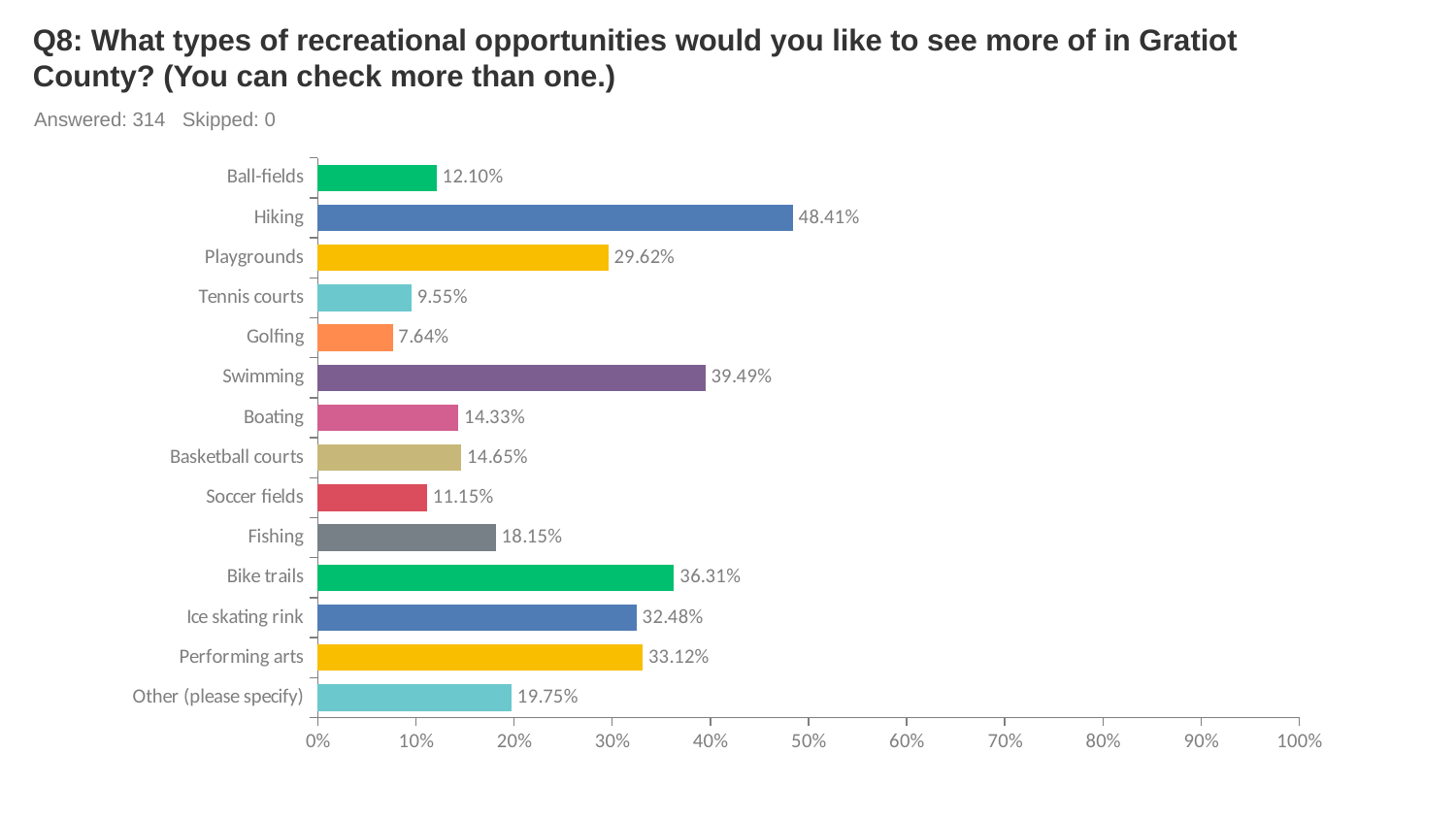
How many categories are shown in the chart? 14 How many respondents answered the question according to the slide? 314 Which category has the lowest percentage? Golfing What percentage is shown for Other (please specify)? 19.75% Which category has the highest percentage? Hiking What type of chart is shown on the slide? Bar chart Which has a higher percentage, Bike trails or Ice skating rink? Bike trails What percentage of respondents selected Hiking? 48.41% What is the difference between Basketball courts and Boating? 0.32% What is the difference between the percentages for Hiking and Swimming? 8.92% Is the value for Playgrounds greater or less than 20%? greater What is the value shown for Swimming? 39.49%